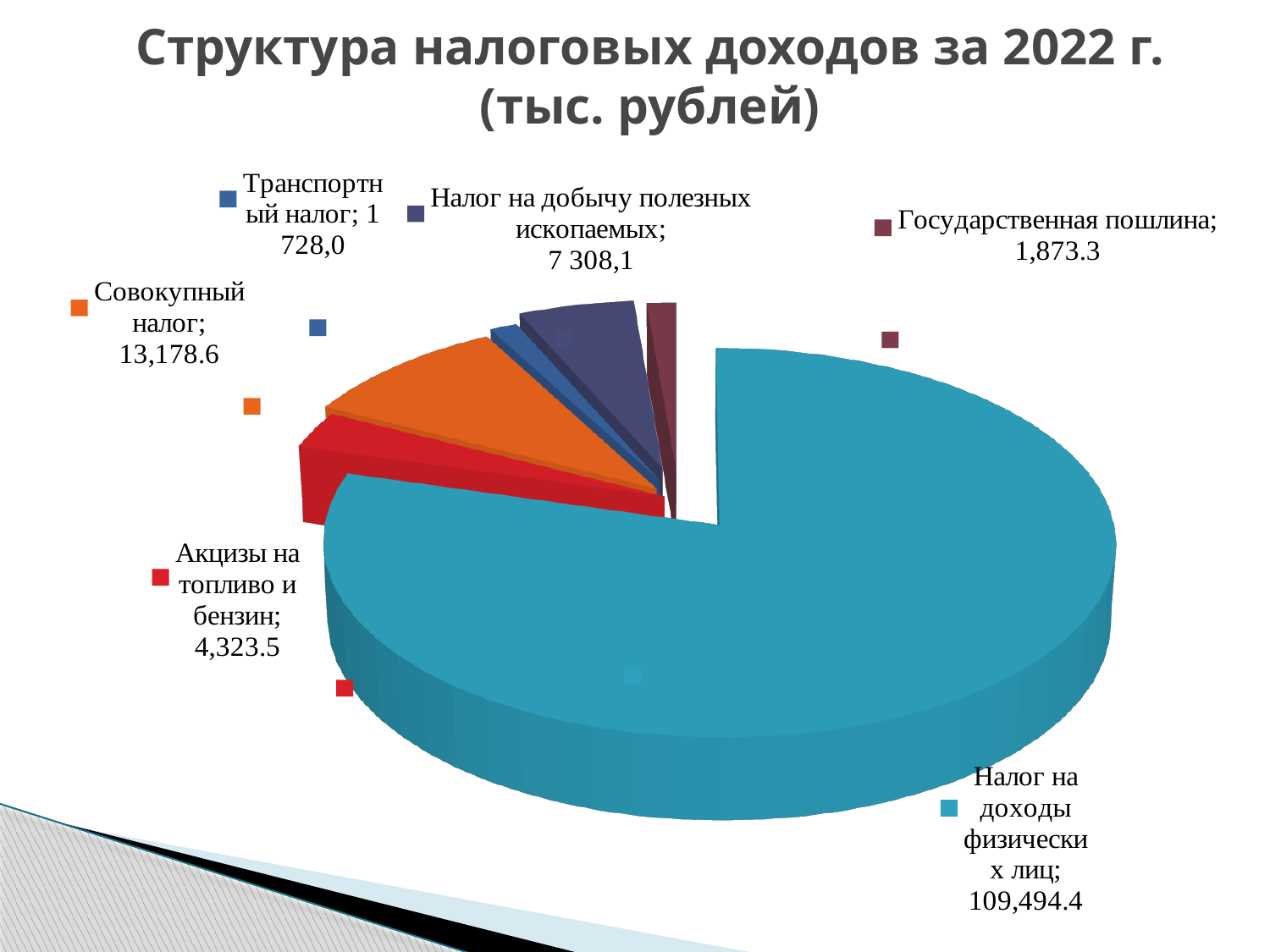
What is the title of the chart? Структура налоговых доходов за 2022 г. (тыс. рублей) Which is larger: Совокупный налог or Акцизы на топливо и бензин? Совокупный налог What is the value for Налог на доходы физических лиц? 109,494.4 What is the value for Совокупный налог? 13,178.6 Which category has the smallest value? Транспортный налог What is the value for Акцизы на топливо и бензин? 4,323.5 What kind of chart is shown on the slide? Pie chart Which category has the largest value? Налог на доходы физических лиц How many categories (slices) does the pie chart have? 6 What is the value for Государственная пошлина? 1,873.3 What is the value for Налог на добычу полезных ископаемых? 7 308,1 What is the difference between Совокупный налог and Акцизы на топливо и бензин? 8,855.1